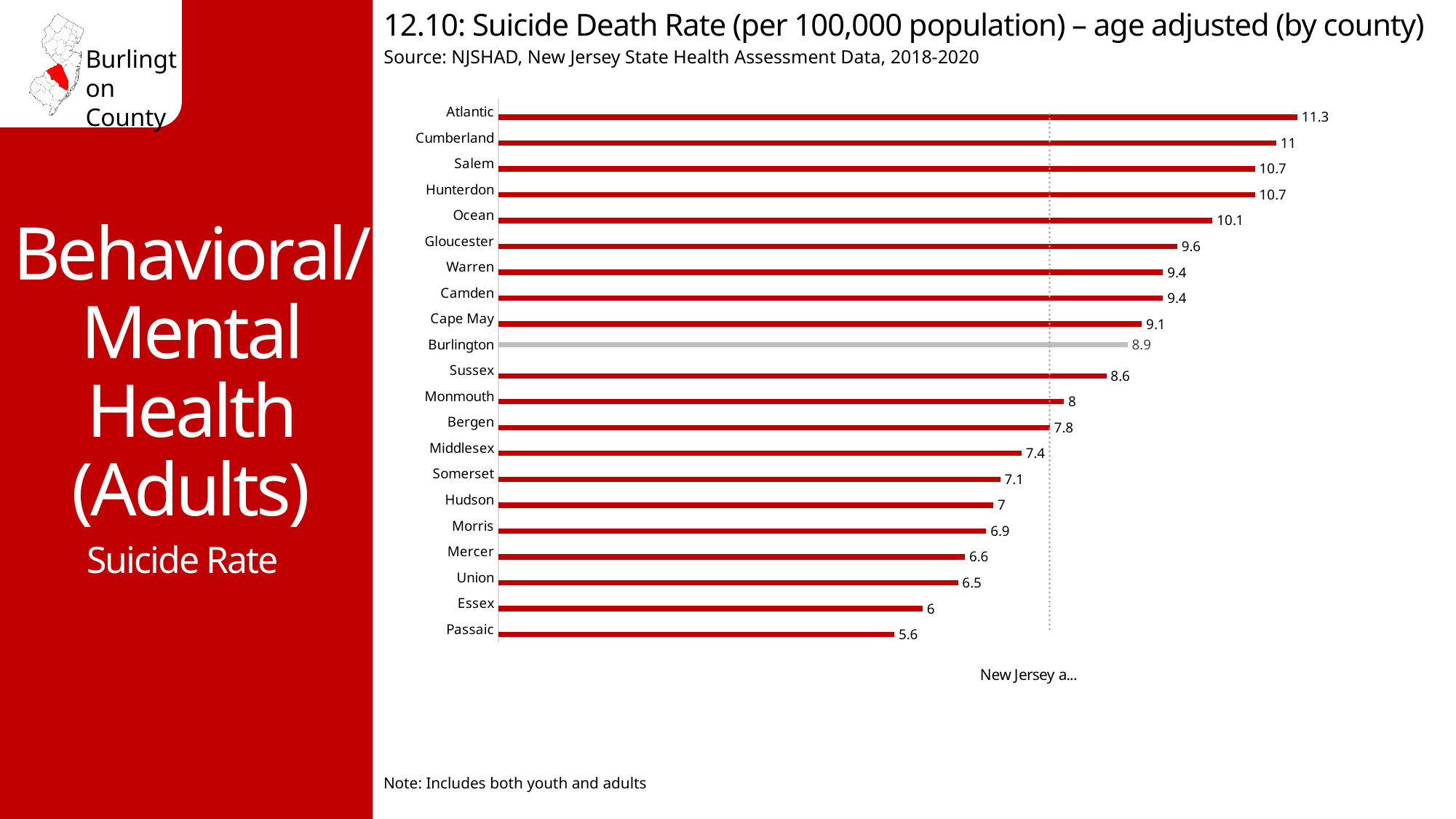
What is the difference between the suicide death rates of Atlantic and Passaic counties? 5.7 What is the suicide death rate for Burlington County? 8.9 Which county has the highest suicide death rate? Atlantic What is the suicide death rate for Passaic County? 5.6 Which county has a higher suicide death rate, Ocean or Gloucester? Ocean What type of chart is used on this slide? Bar chart What is the suicide death rate for Atlantic County? 11.3 Which county's bar is shown in grey rather than red? Burlington What is the difference between the suicide death rates of Burlington and Sussex counties? 0.3 Which county has a higher suicide death rate, Bergen or Monmouth? Monmouth Which county has the lowest suicide death rate? Passaic How many counties are shown in the chart? 21